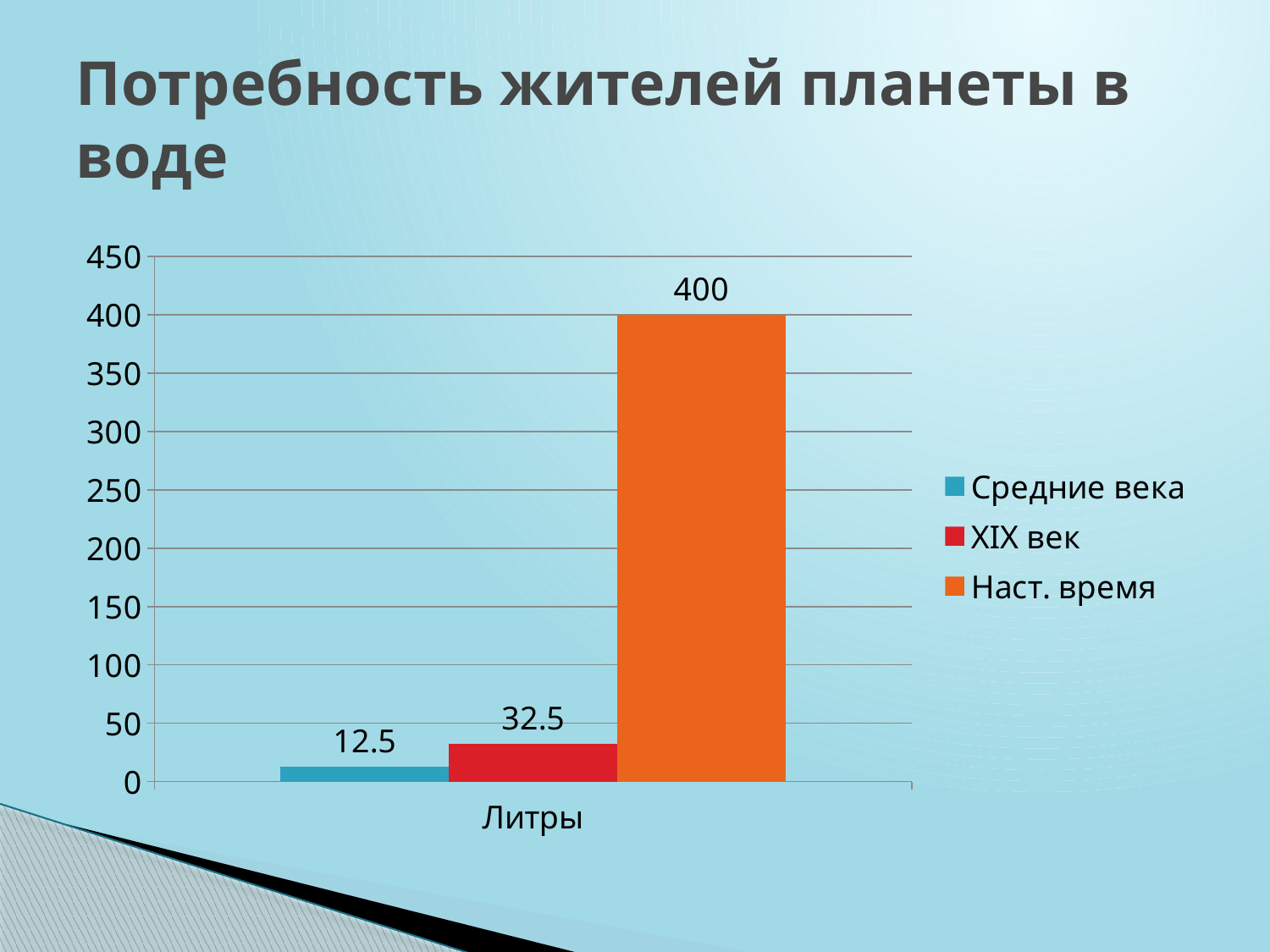
What is the value for Средние века? 12.5 What is the value for XIX век? 32.5 What is the value for Наст. время? 400 How many series does the legend list? 3 What is the difference between the values for Наст. время and XIX век? 367.5 Which is larger, the value for XIX век or the value for Средние века? XIX век What kind of chart is shown on the slide? bar chart Is the value for Наст. время greater or less than 350? greater Which series has the highest value? Наст. время What is the difference between the values for XIX век and Средние века? 20 What is the label on the x axis of the chart? Литры Which series has the lowest value? Средние века